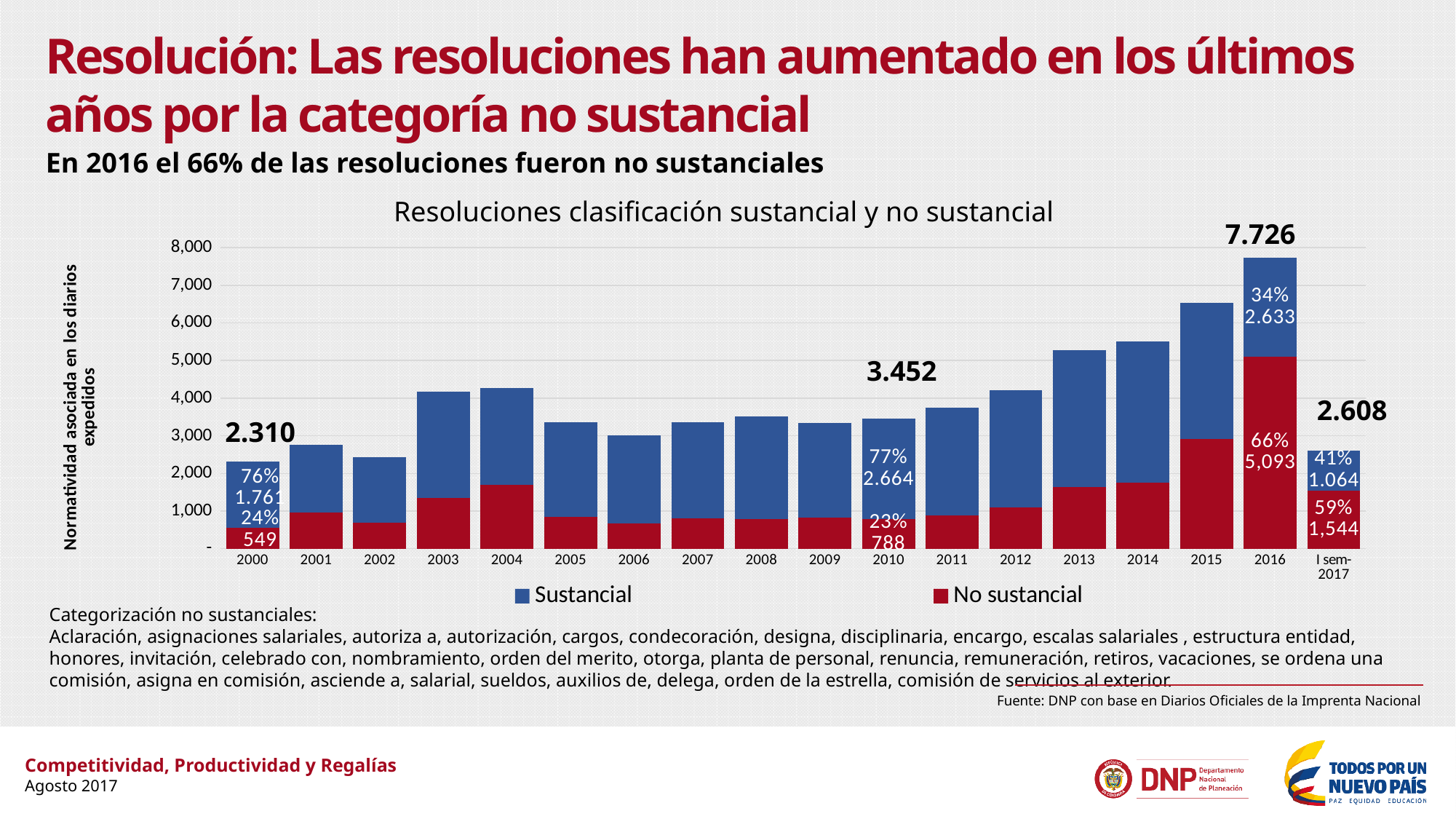
In 2016, which is larger: the Sustancial value or the No sustancial value? No sustancial Which colour represents the No sustancial series? Red What is the Sustancial value for 2010? 2,664 What type of chart is shown on the slide? Stacked bar chart How many categories (years/periods) are shown on the x axis of the chart? 18 Is the total value for 2015 greater or less than 6,000? greater What percentage of resolutions in 2000 were Sustancial? 76% What is the difference between the No sustancial value in 2016 and in 2010? 4,305 What is the No sustancial value for 2016? 5,093 How many series does the legend list in the chart 'Resoluciones clasificación sustancial y no sustancial'? 2 What is the total value labelled for 2016? 7.726 Which year has the highest total bar? 2016